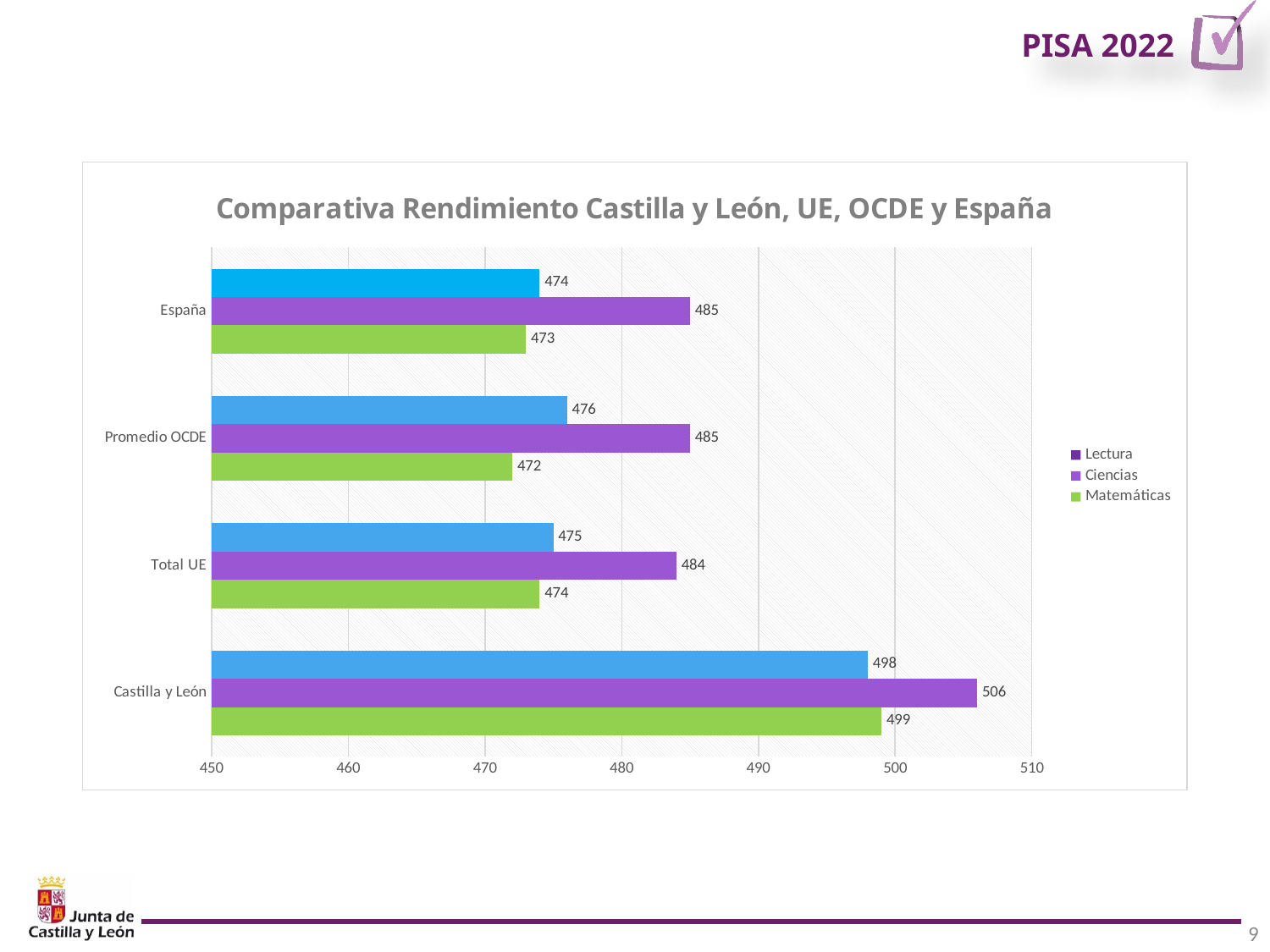
What is the title of the chart? Comparativa Rendimiento Castilla y León, UE, OCDE y España What kind of chart is shown on the slide? Bar chart What is the Ciencias value for España? 485 Which category has the highest Lectura value? Castilla y León What is the difference between the Ciencias value for Castilla y León and the Ciencias value for España? 21 Which category has the lowest Matemáticas value? Promedio OCDE Which is larger: the Lectura value for Promedio OCDE or the Lectura value for Total UE? Promedio OCDE How many categories are shown on the y axis? 4 What is the Matemáticas value for Promedio OCDE? 472 What is the Ciencias value for Castilla y León? 506 What is the Lectura value for Total UE? 475 How many series does the legend list? 3